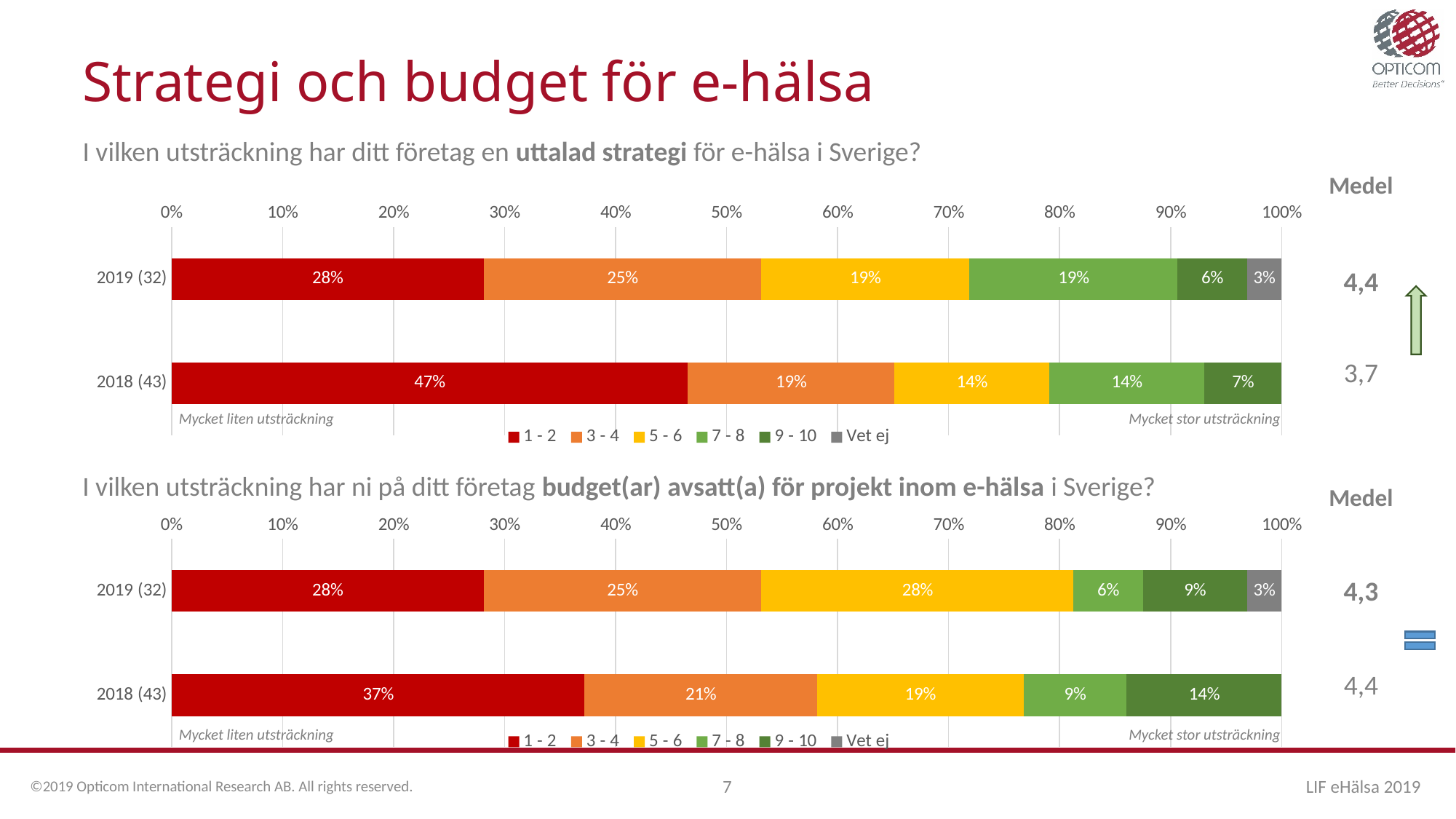
In the top chart (uttalad strategi), which year has the larger 7 - 8 share, 2019 (32) or 2018 (43)? 2019 (32) In the bottom chart (budget för projekt inom e-hälsa), which year has the larger 1 - 2 share, 2019 (32) or 2018 (43)? 2018 (43) How many series does the legend of the top chart (uttalad strategi) list? 6 In the top chart (uttalad strategi), what is the Medel value shown for 2019 (32)? 4,4 In the top chart (uttalad strategi), what is the difference between the 1 - 2 share for 2018 (43) and for 2019 (32)? 19 percentage points How many bars (years) are shown in the bottom chart (budget för projekt inom e-hälsa)? 2 In the top chart (uttalad strategi), what percentage of the 2018 (43) bar is in the 1 - 2 segment? 47% In the bottom chart (budget för projekt inom e-hälsa), what is the Medel value shown for 2018 (43)? 4,4 In the bottom chart (budget för projekt inom e-hälsa), what percentage of the 2019 (32) bar is in the 5 - 6 segment? 28% What kind of chart is the top chart (uttalad strategi)? Stacked bar chart In the top chart (uttalad strategi), what percentage of the 2019 (32) bar is in the 7 - 8 segment? 19% In the bottom chart (budget för projekt inom e-hälsa), what percentage of the 2018 (43) bar is in the 9 - 10 segment? 14%